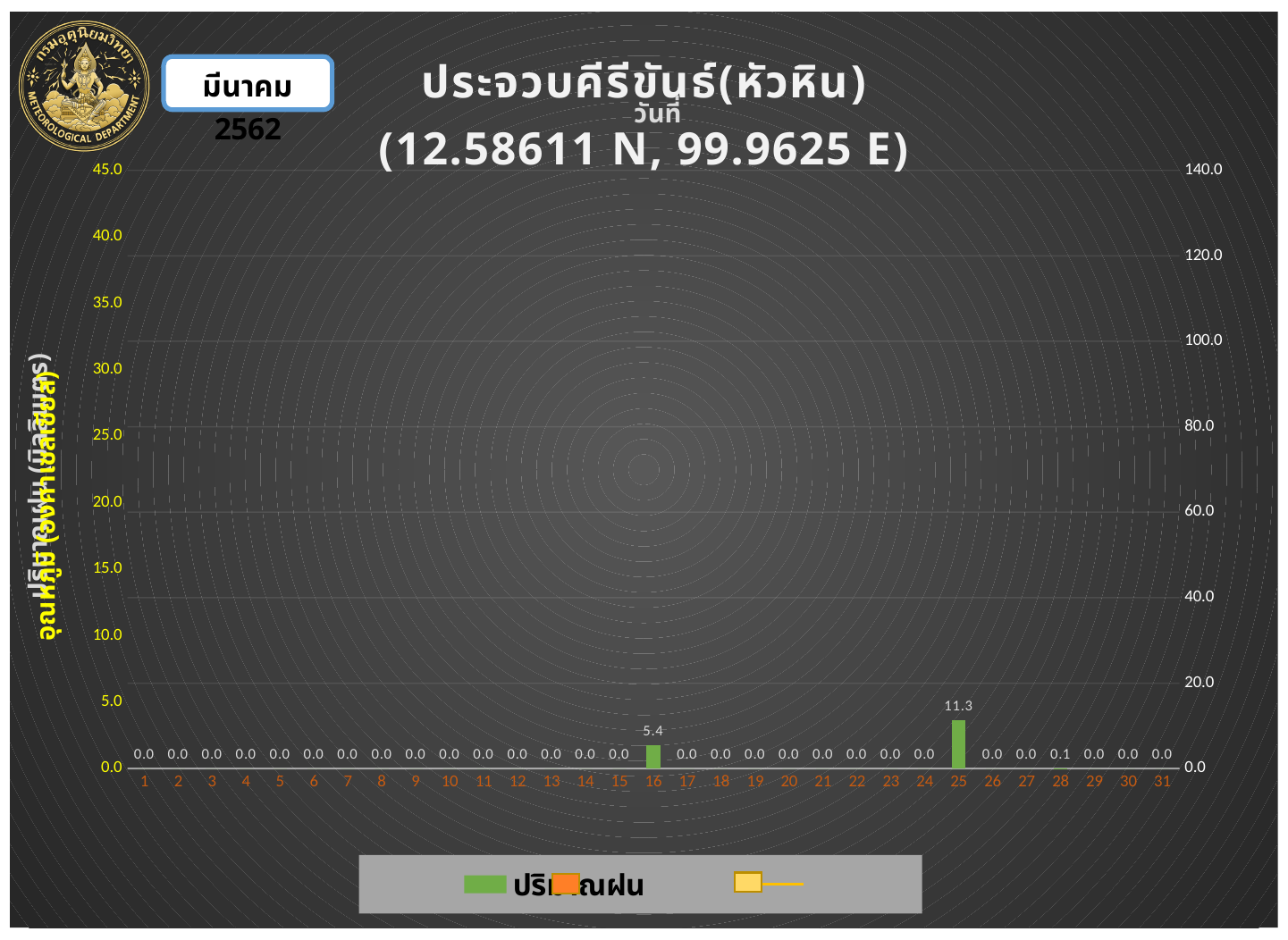
How many days are shown on the x axis? 31 What is the rainfall value shown for day 28? 0.1 Which is larger, the rainfall value for day 16 or for day 25? day 25 What is the difference between the rainfall values for day 25 and day 16? 5.9 Is the rainfall value for day 25 greater or less than 10.0? greater What is the highest tick value on the left vertical axis? 45.0 What is the rainfall value shown for day 25? 11.3 Which day has the highest rainfall value? 25 What is the rainfall value shown for day 10? 0.0 What kind of chart is shown on the slide? bar chart What is the highest tick value on the right vertical axis? 140.0 What is the rainfall value shown for day 16? 5.4